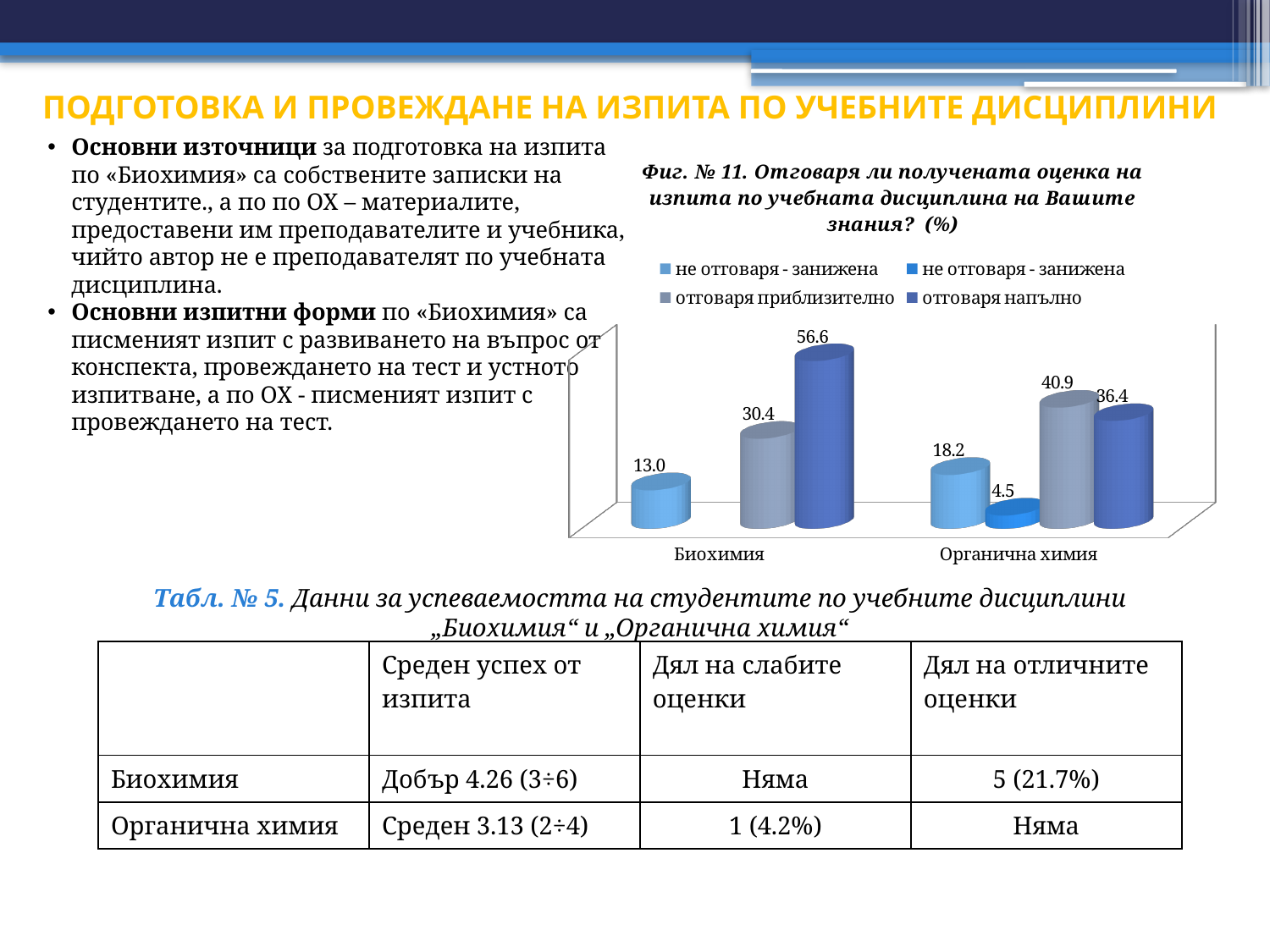
In Fig. 11, what is the value of "отговаря напълно" for Органична химия? 36.4 How many series does the legend of Fig. 11 list? 4 In Fig. 11, what is the smallest labelled value shown for Органична химия? 4.5 In Fig. 11, for Органична химия, which is larger: "отговаря приблизително" or "отговаря напълно"? отговаря приблизително What kind of chart is Fig. 11? bar chart In Fig. 11, which discipline has the higher value for "отговаря напълно"? Биохимия In Fig. 11, what is the difference between the "отговаря напълно" values for Биохимия and Органична химия? 20.2 In Fig. 11, what is the value of "отговаря приблизително" for Органична химия? 40.9 In Fig. 11, what is the value of "отговаря напълно" for Биохимия? 56.6 In Fig. 11, what is the difference between the "отговаря приблизително" values for Органична химия and Биохимия? 10.5 In Fig. 11, what is the value of "отговаря приблизително" for Биохимия? 30.4 How many disciplines (categories) are shown on the x axis of Fig. 11? 2